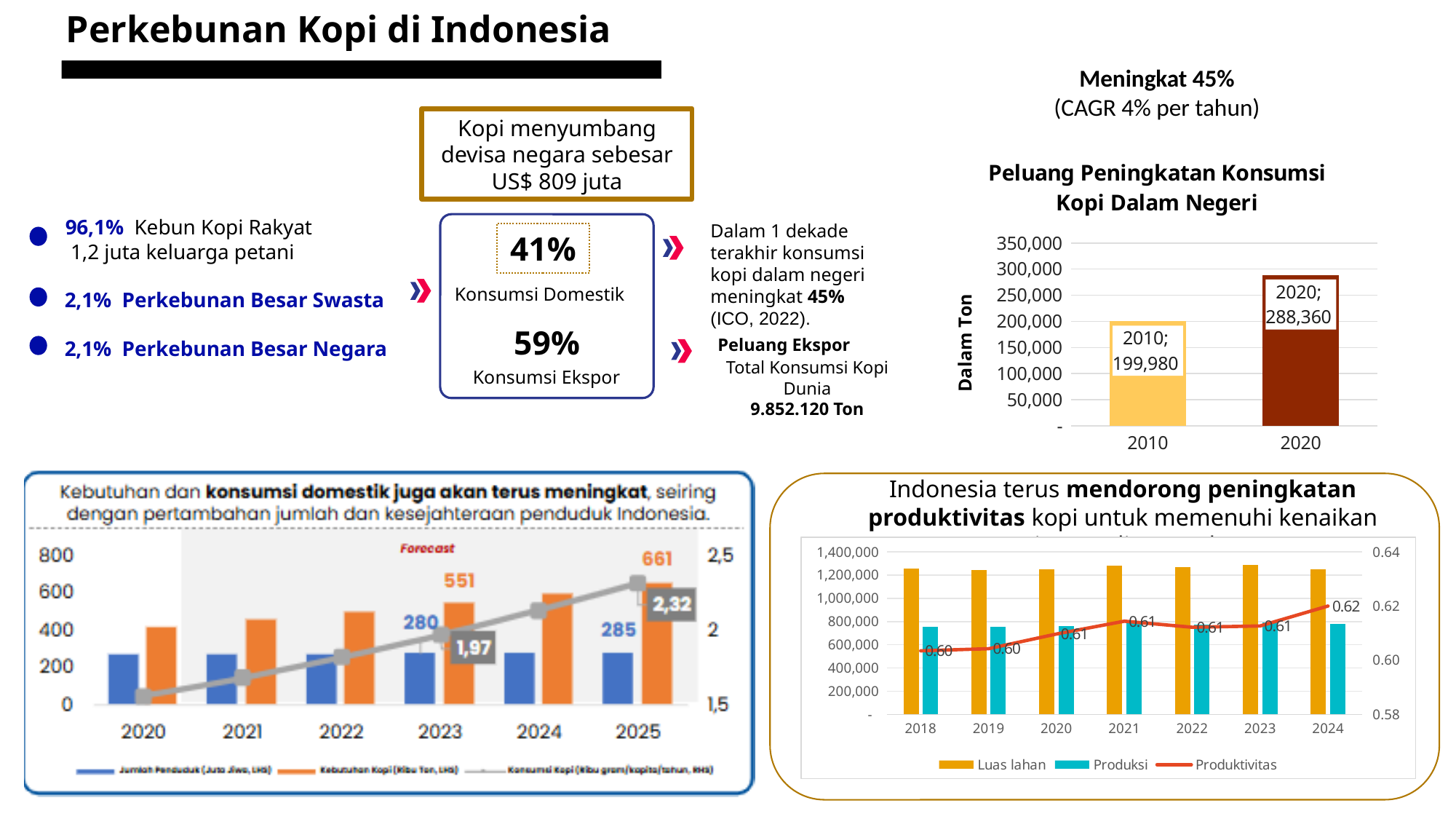
In the bottom-left chart, what is the Konsumsi Kopi line value labelled for 2023? 1,97 In the bottom-right chart, what is the Produktivitas value for 2024? 0.62 In the bottom-right chart, which year has the highest Produktivitas value? 2024 In the bottom-right chart, how many years are shown on the x axis? 7 In the 'Peluang Peningkatan Konsumsi Kopi Dalam Negeri' chart, what is the label on the vertical axis? Dalam Ton In the bottom-left chart, what is the Kebutuhan Kopi value labelled for 2025? 661 What kind of chart is the 'Peluang Peningkatan Konsumsi Kopi Dalam Negeri' chart? Bar chart In the 'Peluang Peningkatan Konsumsi Kopi Dalam Negeri' chart, what is the difference between the 2020 and 2010 values? 88,380 In the 'Peluang Peningkatan Konsumsi Kopi Dalam Negeri' chart, what is the value for 2010? 199,980 In the 'Peluang Peningkatan Konsumsi Kopi Dalam Negeri' chart, what is the value for 2020? 288,360 In the bottom-right chart, is the Luas lahan value for 2018 greater or less than 1,200,000? greater In the bottom-right chart, how many series does the legend list? 3